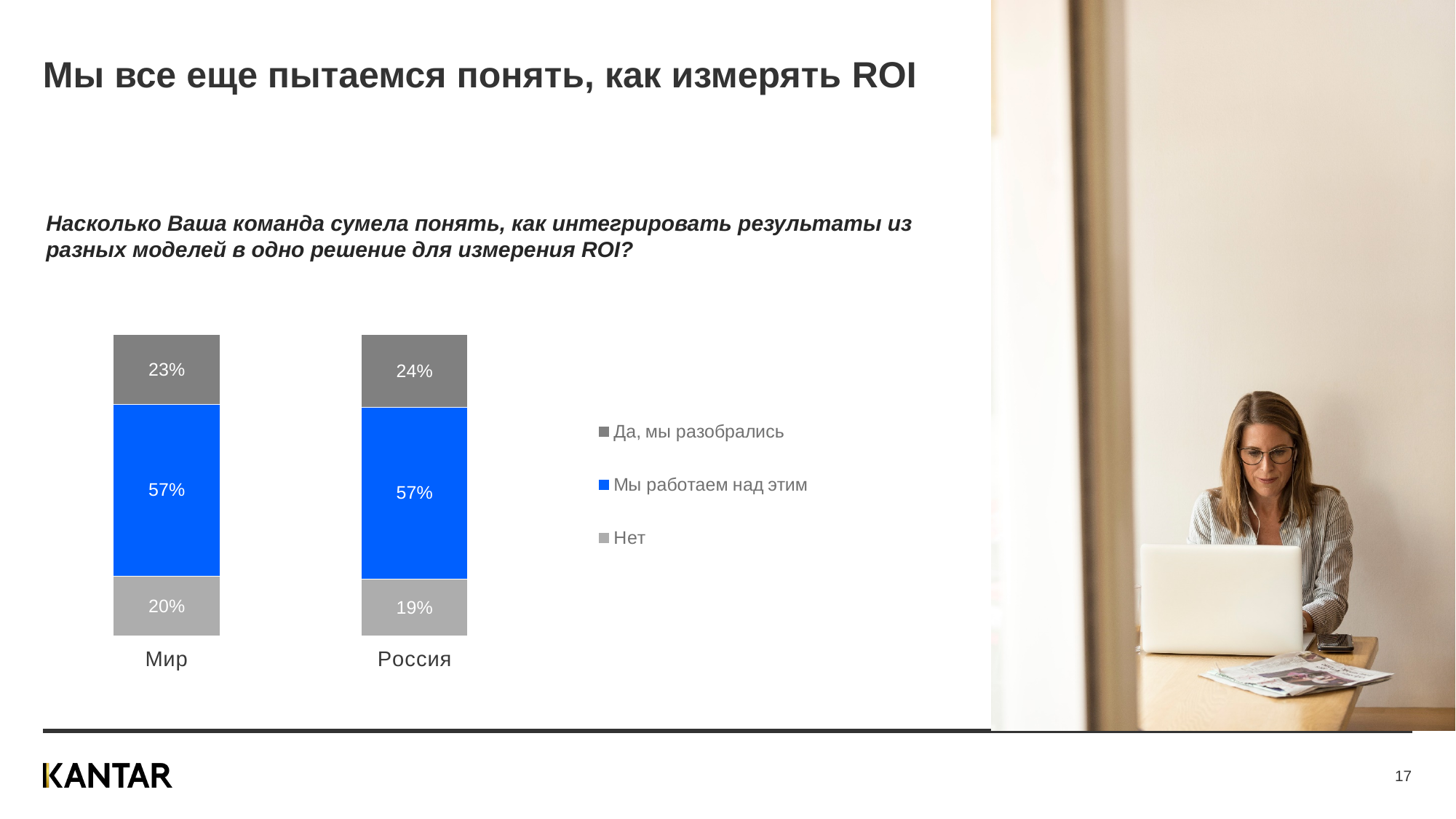
What is the value for "Нет" for Мир? 20% How many series does the chart legend list? 3 What is the difference between the "Мы работаем над этим" value and the "Нет" value for Мир? 37% Which series has the smallest share in the Россия bar? Нет What is the value for "Да, мы разобрались" for Россия? 24% What type of chart is shown on the slide? Stacked bar chart Which series has the largest share in the Мир bar? Мы работаем над этим How many categories are shown on the x axis of the chart? 2 What is the value for "Да, мы разобрались" for Мир? 23% What is the value for "Нет" for Россия? 19% What is the value for "Мы работаем над этим" for Россия? 57% Which colour represents the "Мы работаем над этим" series in the chart? Blue